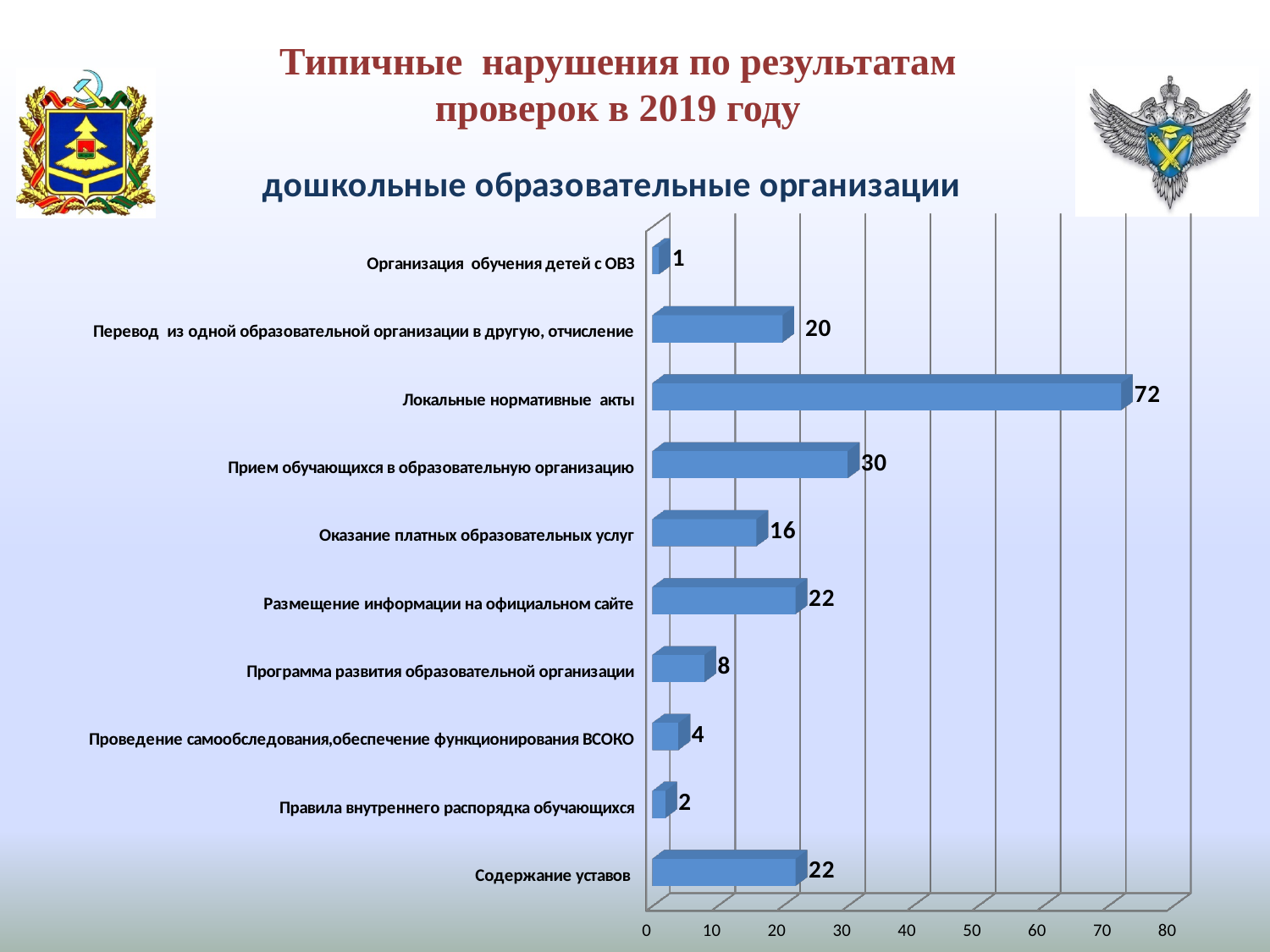
Which is larger: the value for Перевод из одной образовательной организации в другую, отчисление or the value for Размещение информации на официальном сайте? Размещение информации на официальном сайте Which category has the lowest value? Организация обучения детей с ОВЗ What is the title of the chart? дошкольные образовательные организации What is the difference between the values for Локальные нормативные акты and Прием обучающихся в образовательную организацию? 42 How many categories are shown in the chart? 10 What is the value for Оказание платных образовательных услуг? 16 What is the value for Прием обучающихся в образовательную организацию? 30 Which category has the highest value? Локальные нормативные акты What is the value for Проведение самообследования,обеспечение функционирования ВСОКО? 4 What is the total of the values for Содержание уставов and Правила внутреннего распорядка обучающихся? 24 What kind of chart is shown on the slide? Bar chart What is the value for Локальные нормативные акты? 72